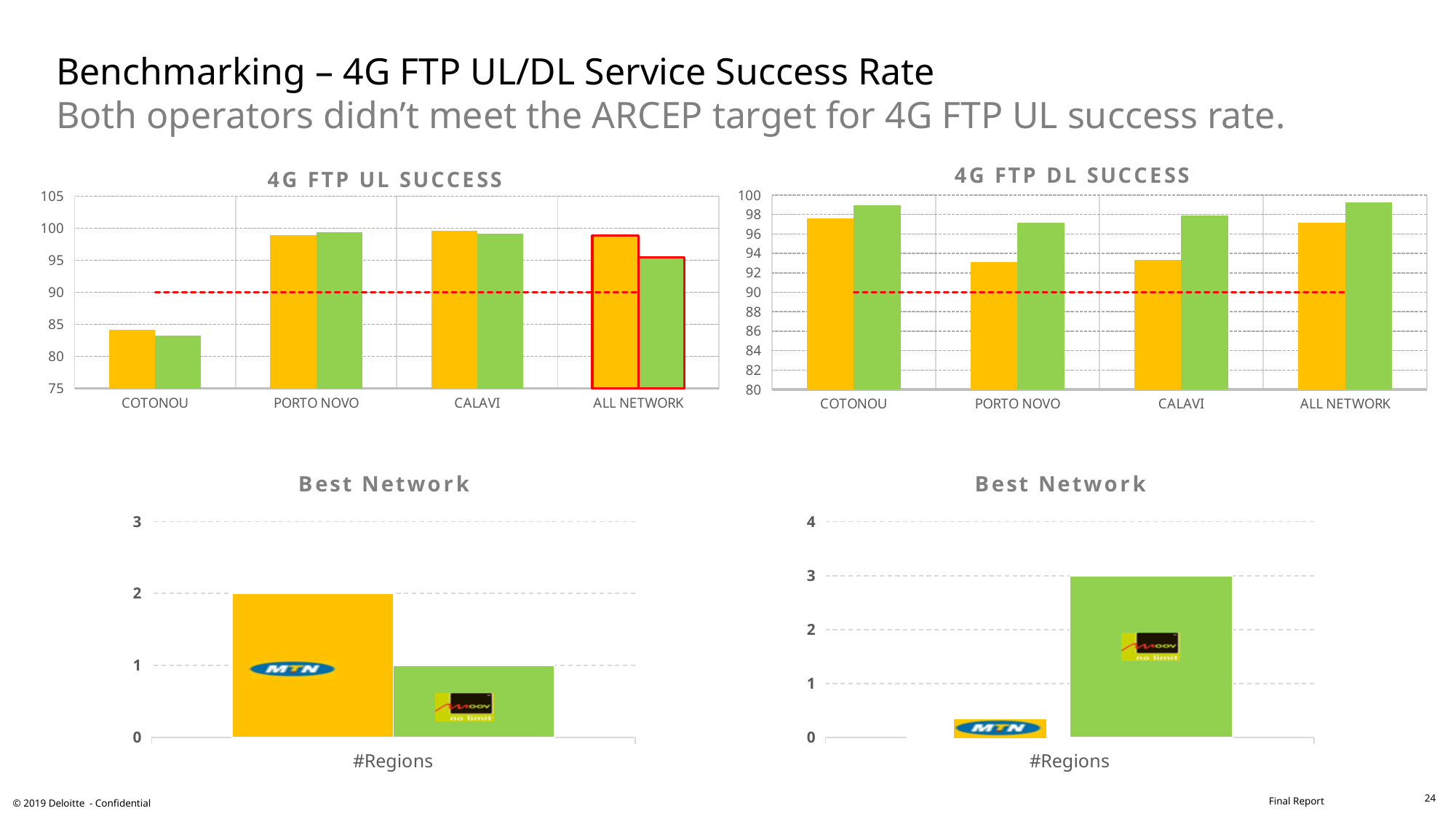
In the '4G FTP DL SUCCESS' chart, is the yellow bar for PORTO NOVO greater or less than 94? less In the bottom-left 'Best Network' chart, what is the value of the green (Moov) bar for #Regions? 1 In the '4G FTP UL SUCCESS' chart, is the yellow bar for COTONOU greater or less than 85? less What kind of chart is the '4G FTP UL SUCCESS' chart? bar chart In the '4G FTP UL SUCCESS' chart, which category has the lowest values? COTONOU How many categories are shown on the x axis of the '4G FTP DL SUCCESS' chart? 4 In the bottom-right 'Best Network' chart, what is the value of the green (Moov) bar for #Regions? 3 In the bottom-right 'Best Network' chart, what is the difference between the green (Moov) bar and the yellow (MTN) bar? 3 In the bottom-right 'Best Network' chart, what is the value of the yellow (MTN) bar for #Regions? 0 In the '4G FTP DL SUCCESS' chart, for PORTO NOVO, which bar is larger, the yellow bar or the green bar? the green bar In the bottom-left 'Best Network' chart, what is the value of the yellow (MTN) bar for #Regions? 2 In the bottom-left 'Best Network' chart, which bar is larger, the yellow (MTN) bar or the green (Moov) bar? the yellow (MTN) bar